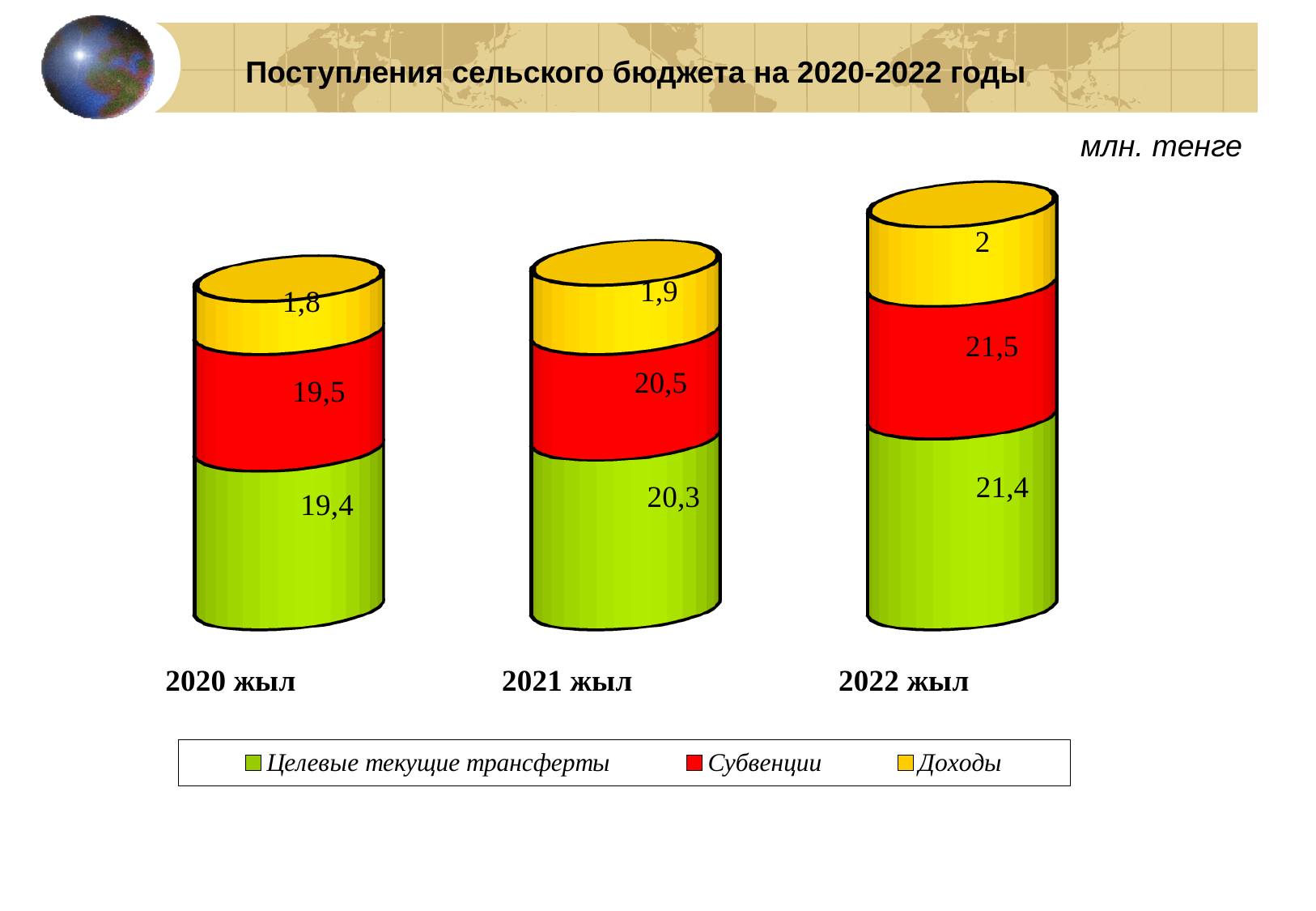
What kind of chart is shown on the slide? Stacked bar chart What is the value of Доходы for 2022 жыл? 2 How many series does the legend list? 3 What is the total of the stacked bar for 2021 жыл? 42,7 What is the difference between the Субвенции values for 2022 жыл and 2020 жыл? 2 What is the value of Субвенции for 2021 жыл? 20,5 Which year has the lowest value for Доходы? 2020 жыл Do the Доходы values rise or fall from 2020 жыл to 2022 жыл? Rise Which year has the highest value for Целевые текущие трансферты? 2022 жыл Which is larger: Целевые текущие трансферты for 2021 жыл or Субвенции for 2020 жыл? Целевые текущие трансферты for 2021 жыл What is the value of Целевые текущие трансферты for 2020 жыл? 19,4 How many years (categories) are shown on the chart? 3